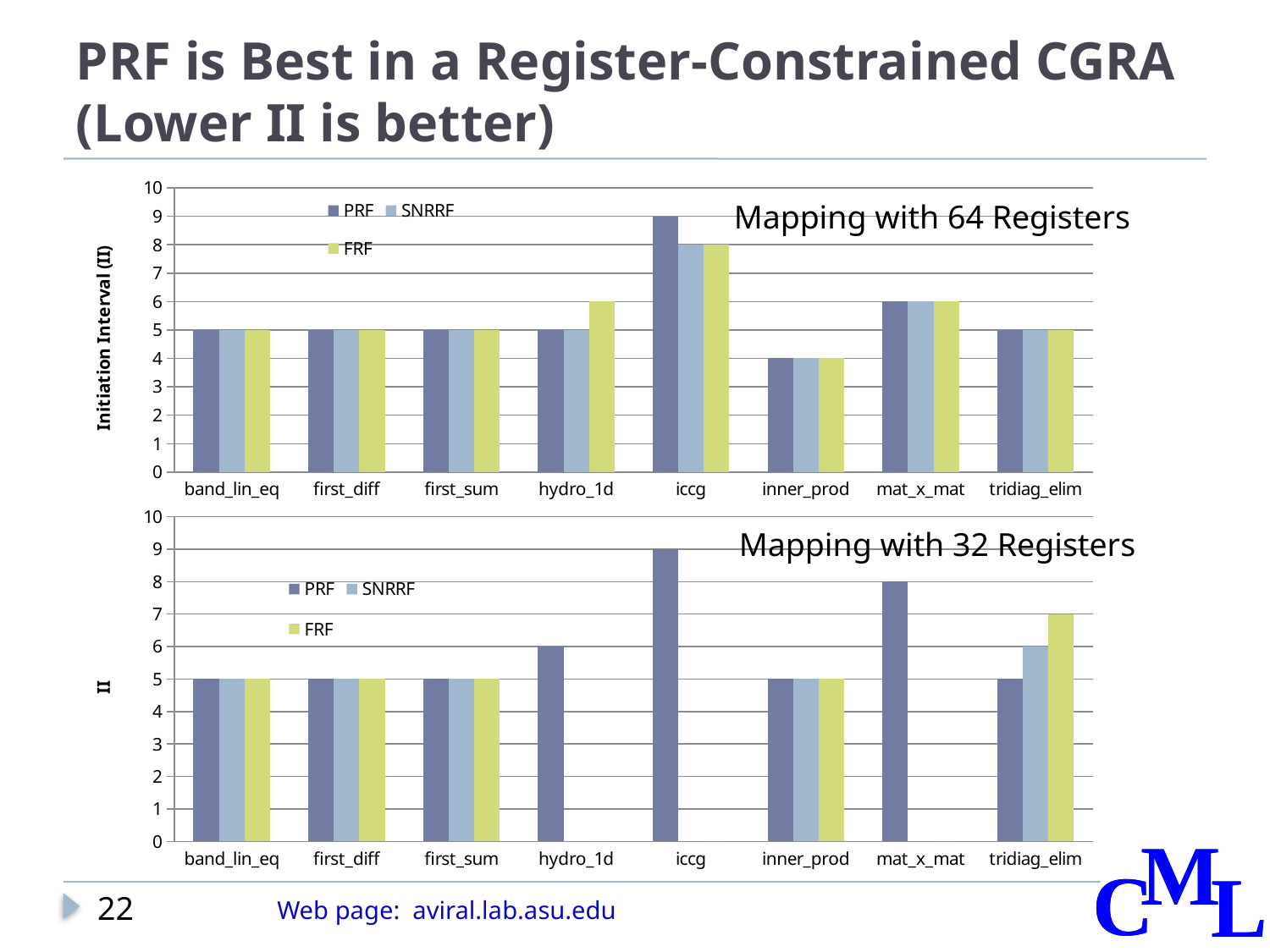
How many series does the legend of the 'Mapping with 32 Registers' chart list? 3 In the 'Mapping with 64 Registers' chart, what is the FRF value for hydro_1d? 6 In the 'Mapping with 32 Registers' chart, what is the FRF value for tridiag_elim? 7 What type of chart is the 'Mapping with 64 Registers' chart? Bar chart In the 'Mapping with 32 Registers' chart, which is larger for tridiag_elim: the SNRRF value or the FRF value? FRF In the 'Mapping with 64 Registers' chart, what is the difference between the PRF and SNRRF values for iccg? 1 In the 'Mapping with 32 Registers' chart, which category has the highest PRF value? iccg In the 'Mapping with 32 Registers' chart, what is the PRF value for mat_x_mat? 8 In the 'Mapping with 64 Registers' chart, which category has the lowest PRF value? inner_prod In the 'Mapping with 32 Registers' chart, what is the difference between the FRF and PRF values for tridiag_elim? 2 In the 'Mapping with 64 Registers' chart, what is the PRF value for iccg? 9 How many categories are shown on the x axis of the 'Mapping with 64 Registers' chart? 8